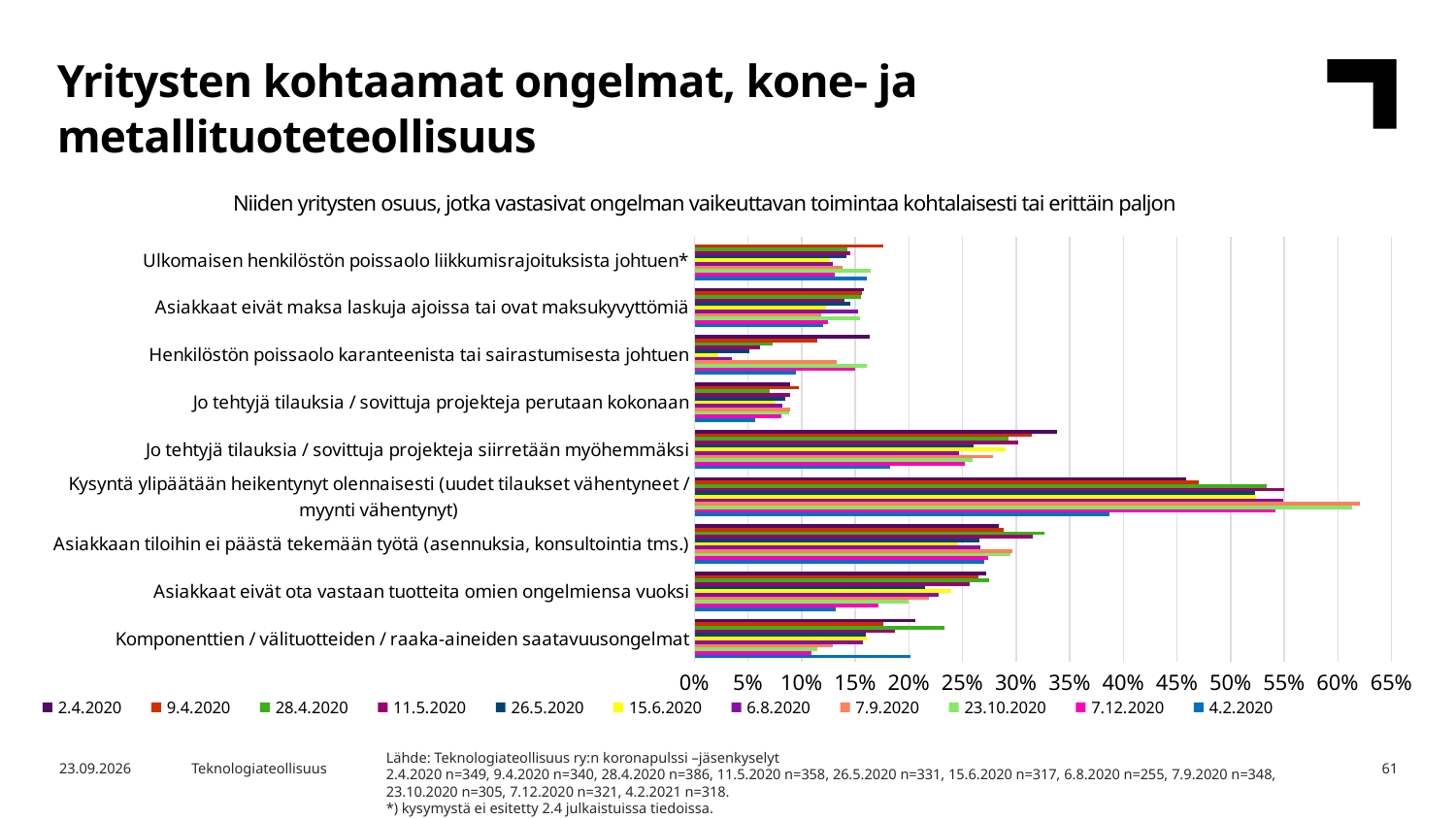
What is the subtitle shown above the chart? Niiden yritysten osuus, jotka vastasivat ongelman vaikeuttavan toimintaa kohtalaisesti tai erittäin paljon Is the 2.4.2020 value for 'Jo tehtyjä tilauksia / sovittuja projekteja siirretään myöhemmäksi' greater or less than 30%? greater What is the highest tick value shown on the chart's horizontal axis? 65% Which category has the highest values on the chart? Kysyntä ylipäätään heikentynyt olennaisesti (uudet tilaukset vähentyneet / myynti vähentynyt) For the 2.4.2020 series, which is larger: 'Kysyntä ylipäätään heikentynyt olennaisesti' or 'Jo tehtyjä tilauksia / sovittuja projekteja perutaan kokonaan'? Kysyntä ylipäätään heikentynyt olennaisesti What kind of chart is shown on the slide? bar chart How many series does the chart's legend list? 11 Is the 7.9.2020 value for 'Kysyntä ylipäätään heikentynyt olennaisesti' greater or less than 50%? greater Is the 4.2.2020 value for 'Kysyntä ylipäätään heikentynyt olennaisesti' greater or less than 35%? greater How many categories (problem types) are listed on the chart's vertical axis? 9